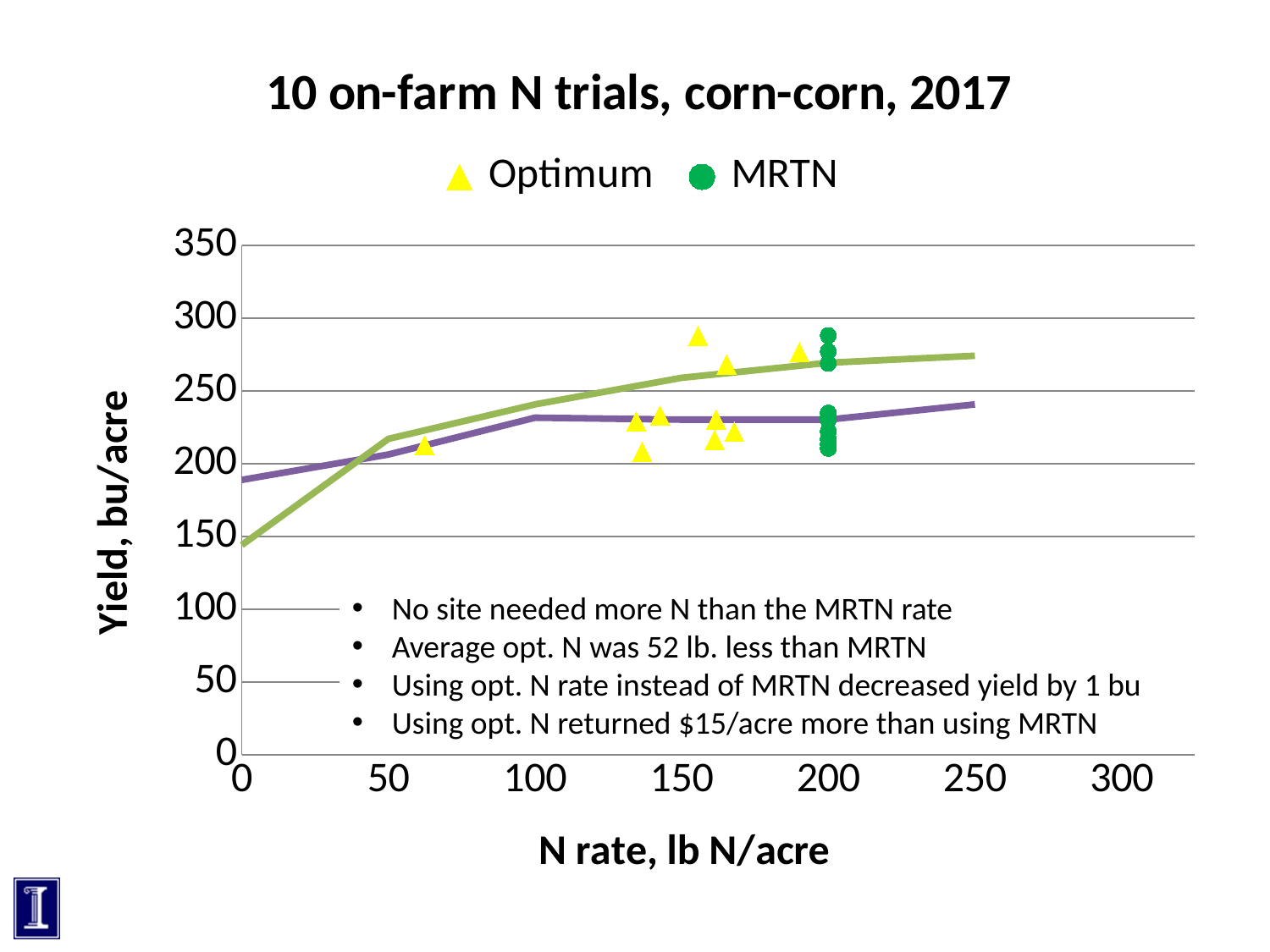
Is the highest MRTN point greater or less than 250 bu/acre? greater At what N rate (lb N/acre) are all the MRTN points plotted? 200 At an N rate of 0, which line has the higher yield value, the green line or the purple line? purple line What are the two series named in the chart legend? Optimum and MRTN How many series does the chart legend list? 2 Is the value of the purple line at an N rate of 250 greater or less than 250? less Is the value of the green line at an N rate of 250 greater or less than 250? greater What kind of chart is shown on the slide? scatter chart Does the green line rise or fall as the N rate increases from 0 to 250? rise What is the title of the chart? 10 on-farm N trials, corn-corn, 2017